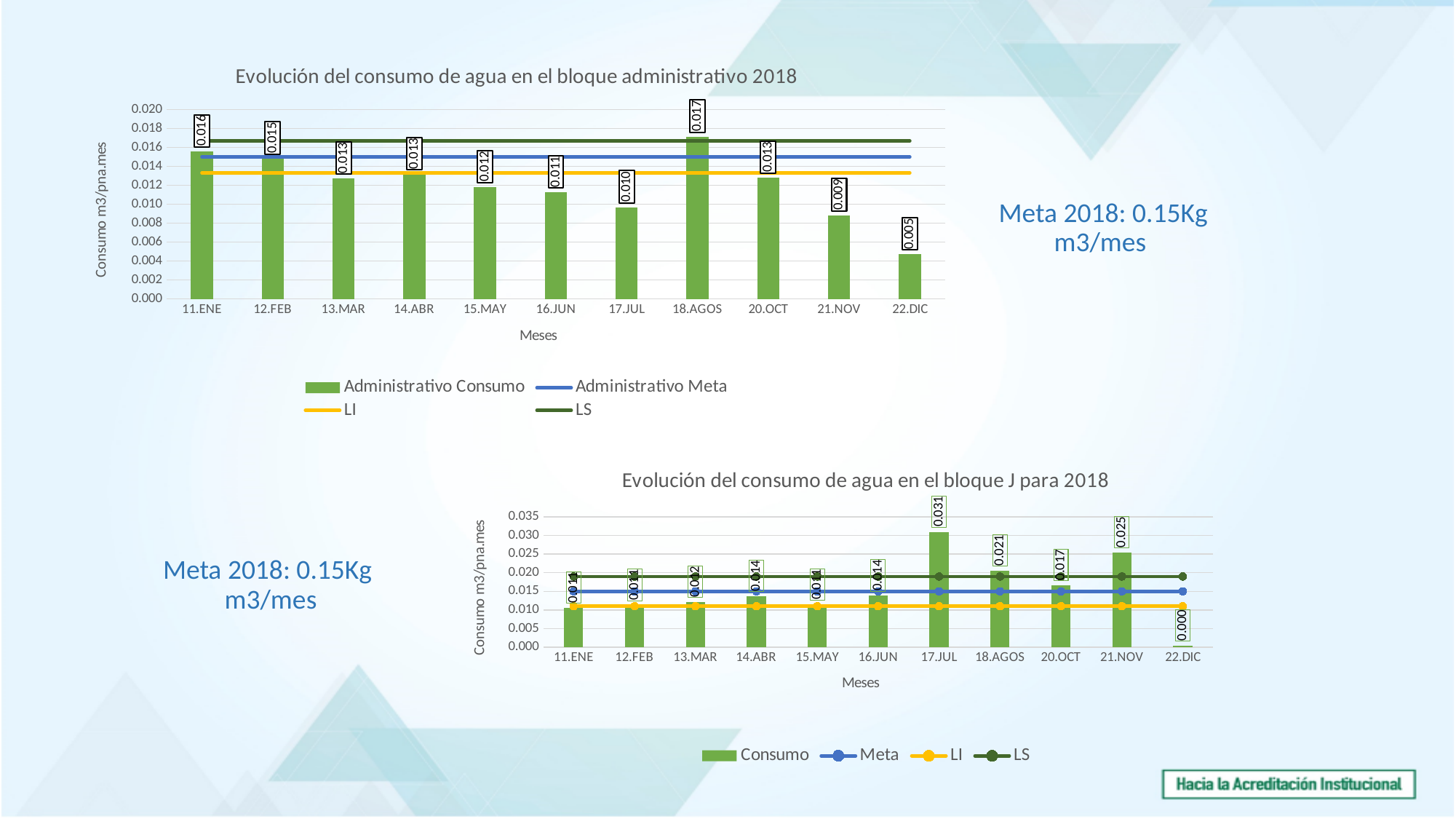
In the chart 'Evolución del consumo de agua en el bloque administrativo 2018', how many months are shown on the x axis? 11 In the chart 'Evolución del consumo de agua en el bloque administrativo 2018', how many entries does the legend list? 4 In the chart 'Evolución del consumo de agua en el bloque administrativo 2018', what is the difference between the Administrativo Consumo values for 11.ENE and 17.JUL? 0.006 In the chart 'Evolución del consumo de agua en el bloque J para 2018', what is the Consumo value for 21.NOV? 0.025 In the chart 'Evolución del consumo de agua en el bloque J para 2018', which is larger, the Consumo value for 18.AGOS or for 20.OCT? 18.AGOS What kind of chart is used to show the Consumo series in the chart 'Evolución del consumo de agua en el bloque J para 2018'? Bar chart In the chart 'Evolución del consumo de agua en el bloque administrativo 2018', which month has the lowest Administrativo Consumo value? 22.DIC In the chart 'Evolución del consumo de agua en el bloque J para 2018', which month has the highest Consumo value? 17.JUL In the chart 'Evolución del consumo de agua en el bloque administrativo 2018', what is the Administrativo Consumo value for 22.DIC? 0.005 In the chart 'Evolución del consumo de agua en el bloque J para 2018', what is the Consumo value for 17.JUL? 0.031 In the chart 'Evolución del consumo de agua en el bloque administrativo 2018', which month has the highest Administrativo Consumo value? 18.AGOS In the chart 'Evolución del consumo de agua en el bloque administrativo 2018', what is the Administrativo Consumo value for 18.AGOS? 0.017